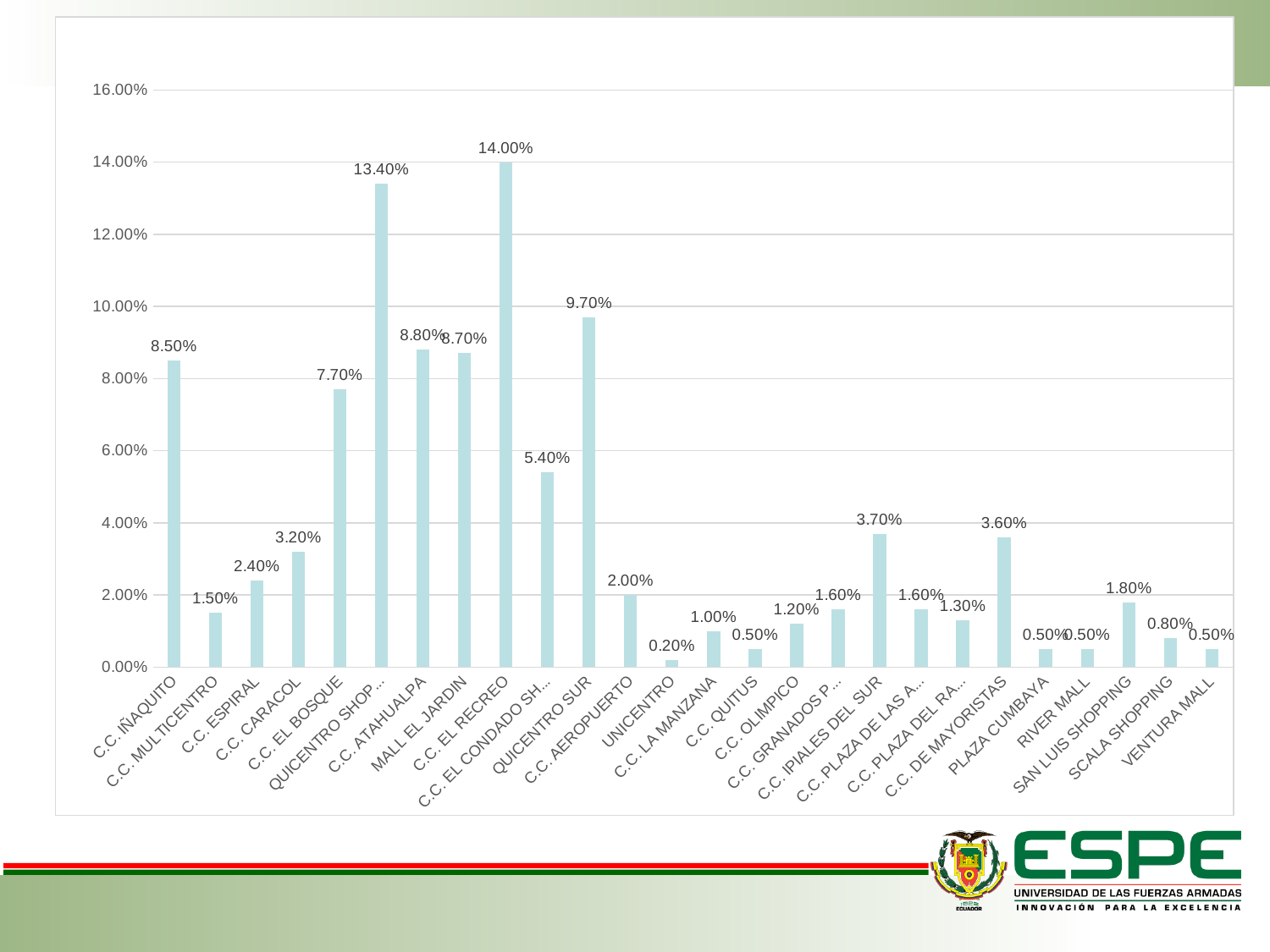
What is the value for SAN LUIS SHOPPING? 1.80% Which is larger, the value for C.C. EL BOSQUE or the value for C.C. EL CONDADO SH...? C.C. EL BOSQUE What kind of chart is shown on the slide? bar chart Which category has the lowest value? UNICENTRO What is the difference between the values for C.C. EL RECREO and C.C. IÑAQUITO? 5.50% How many categories are shown on the x axis? 26 Is the value for C.C. ATAHUALPA greater or less than 8.00%? greater Which category has the highest value? C.C. EL RECREO What is the value for QUICENTRO SUR? 9.70% What is the value for C.C. IPIALES DEL SUR? 3.70% What is the difference between the values for C.C. DE MAYORISTAS and C.C. CARACOL? 0.40% What is the value for C.C. EL RECREO? 14.00%